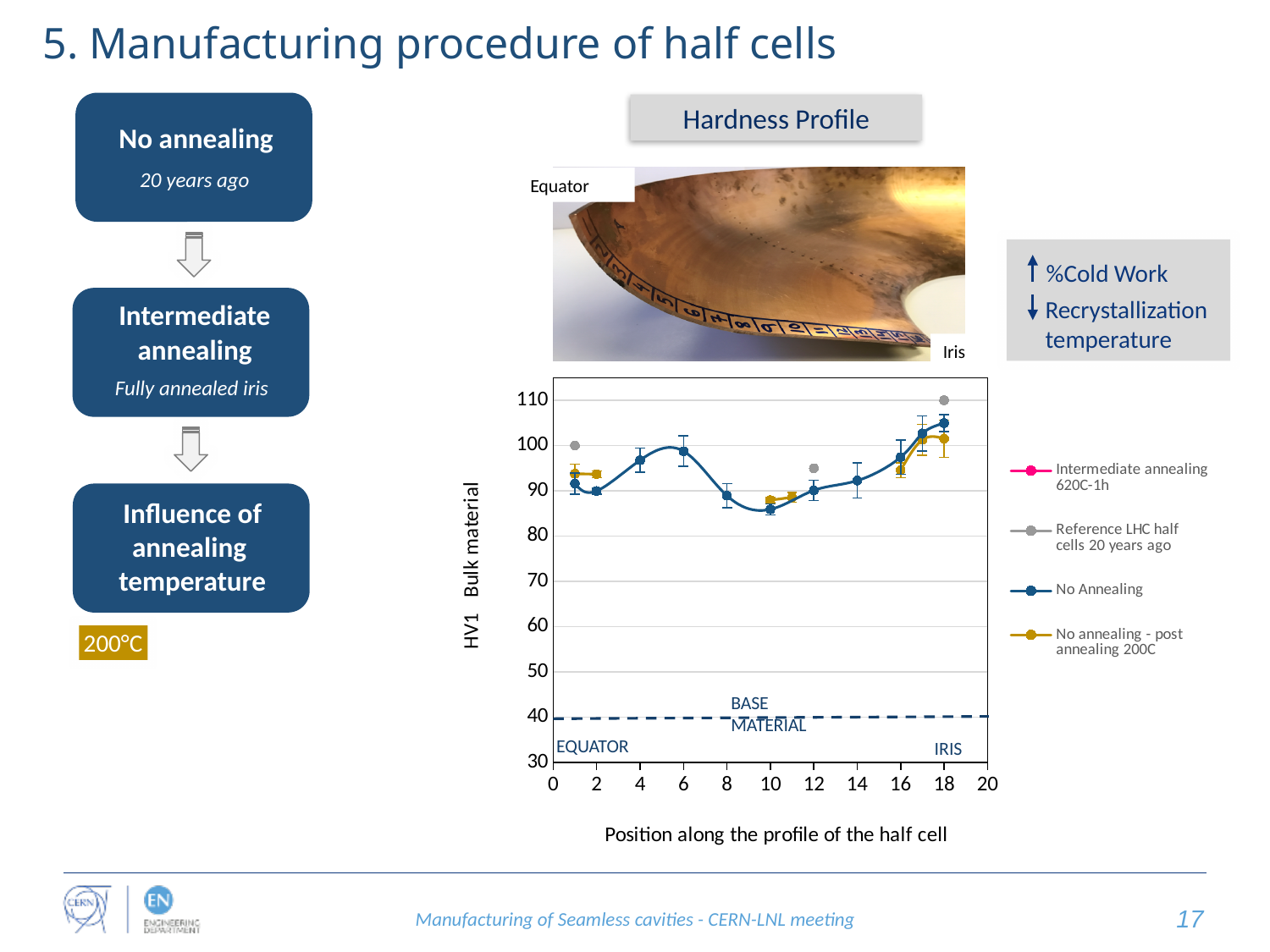
What is the title of the y axis of the Hardness Profile chart? HV1 Bulk material In the Hardness Profile chart, is the No Annealing value at position 18 greater or less than 100? greater In the Hardness Profile chart, which series has the highest value at position 18? Reference LHC half cells 20 years ago In the Hardness Profile chart, is the No Annealing value at position 6 greater or less than 90? greater In the Hardness Profile chart, is the No Annealing value at position 10 greater or less than 90? less How many series does the legend of the Hardness Profile chart list? 4 In the Hardness Profile chart, which is larger for the No Annealing series: the value at position 6 or the value at position 10? position 6 In the Hardness Profile chart, do the No Annealing values rise or fall between position 12 and position 18? rise What is the title of the x axis of the Hardness Profile chart? Position along the profile of the half cell What kind of chart is shown under the 'Hardness Profile' heading? line chart At what y-axis value does the dashed BASE MATERIAL line sit in the Hardness Profile chart? 40